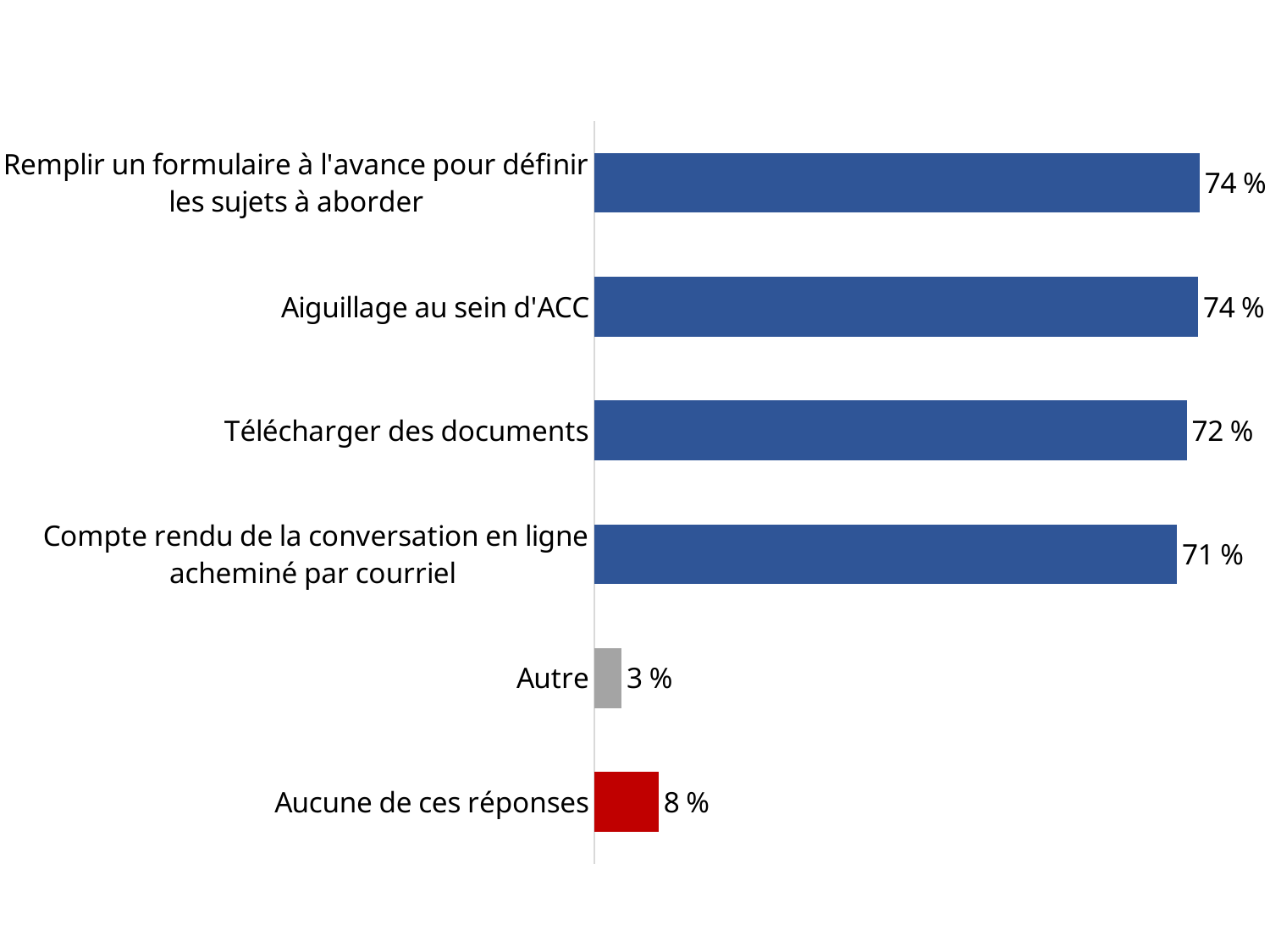
What kind of chart is shown on the slide? Bar chart Which is larger, the value for "Télécharger des documents" or the value for "Compte rendu de la conversation en ligne acheminé par courriel"? Télécharger des documents Which category has the lowest value? Autre What is the difference between the values for "Télécharger des documents" and "Autre"? 69 % What is the value for "Compte rendu de la conversation en ligne acheminé par courriel"? 71 % Which is larger, the value for "Aucune de ces réponses" or the value for "Autre"? Aucune de ces réponses What is the value for "Télécharger des documents"? 72 % How many categories are shown in the chart? 6 What is the value for "Autre"? 3 % What is the difference between the values for "Aucune de ces réponses" and "Autre"? 5 % What colour is the bar for "Aucune de ces réponses"? Red What is the value for "Aucune de ces réponses"? 8 %